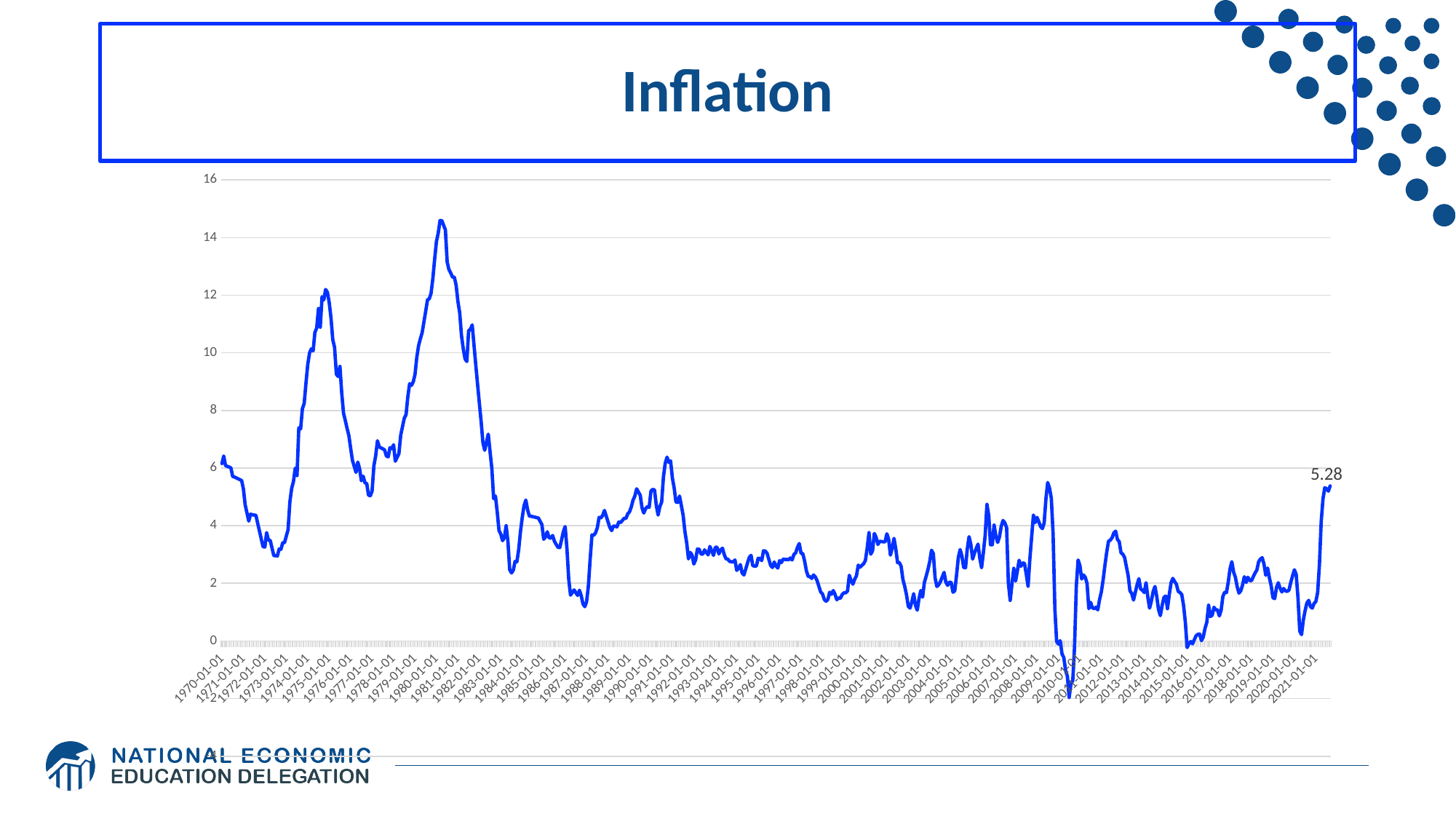
How many lines are plotted on the chart? 1 Which peak is higher, the one around 1980 or the one around 1975? the one around 1980 Is the peak of the line around 1975-01-01 greater or less than 10? greater Is the value at 1970-01-01 greater or less than 4? greater What is the highest value shown on the vertical axis? 16 Between 1980-01-01 and 1983-01-01, does the line generally rise or fall? fall Is the lowest value between 1986-01-01 and 1988-01-01 greater or less than 2? less What is the title of the chart? Inflation What kind of chart is shown on the slide? line chart What value is printed as the data label at the right end of the line? 5.28